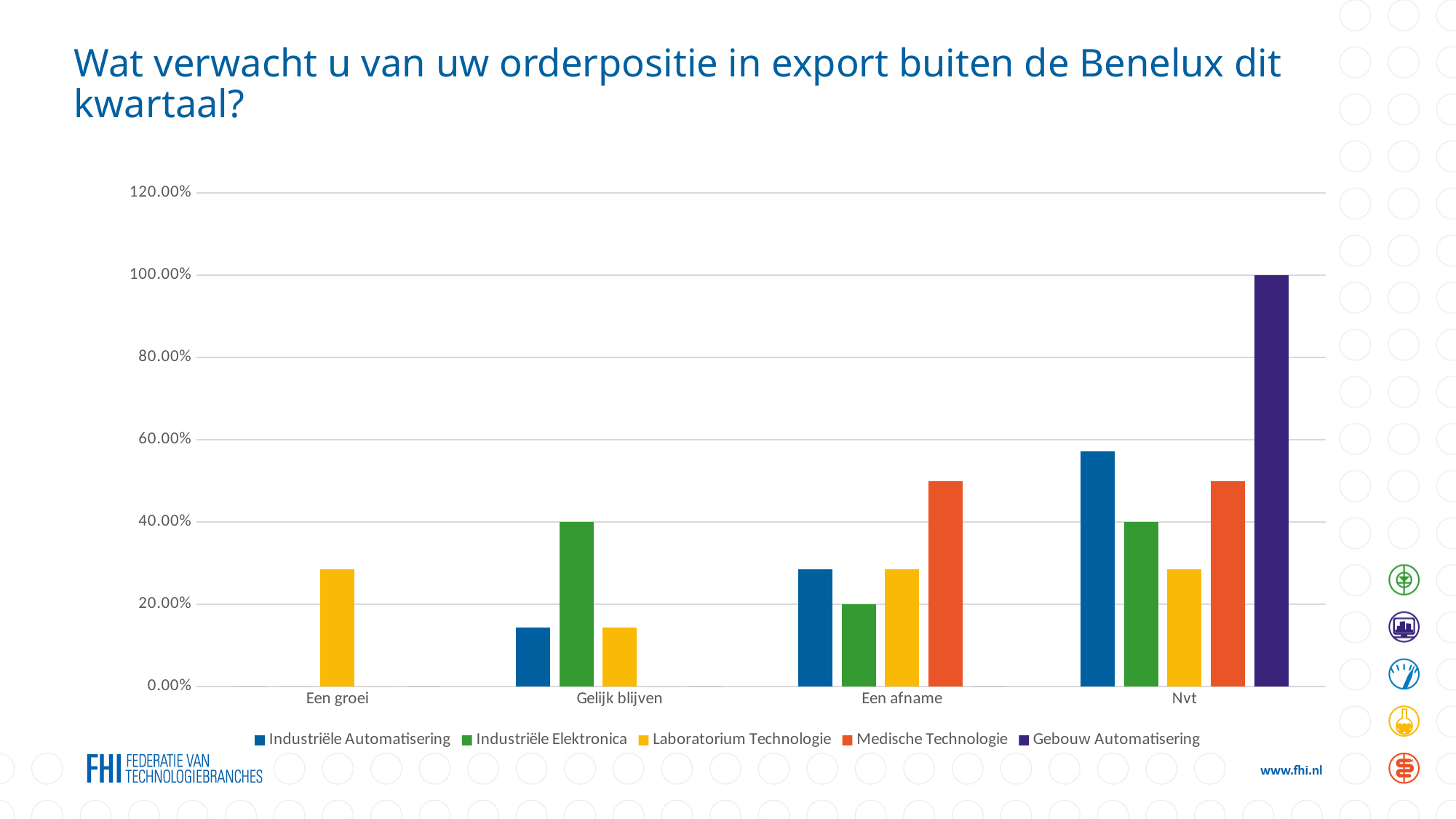
Is the value for Industriële Automatisering in the Nvt category greater or less than 40.00%? greater What is the value for Industriële Elektronica in the Een afname category? 20.00% Is the value for Laboratorium Technologie in the Een groei category greater or less than 40.00%? less In the Een afname category, which is larger: Medische Technologie or Industriële Automatisering? Medische Technologie What type of chart is shown on the slide? bar chart Which series has the lowest value in the Een afname category? Gebouw Automatisering What is the value for Gebouw Automatisering in the Nvt category? 100.00% Which series has the highest value in the Nvt category? Gebouw Automatisering How many series does the legend list? 5 Which series is the only one with a bar in the Een groei category? Laboratorium Technologie What is the value for Industriële Elektronica in the Gelijk blijven category? 40.00% How many categories are shown on the x axis? 4